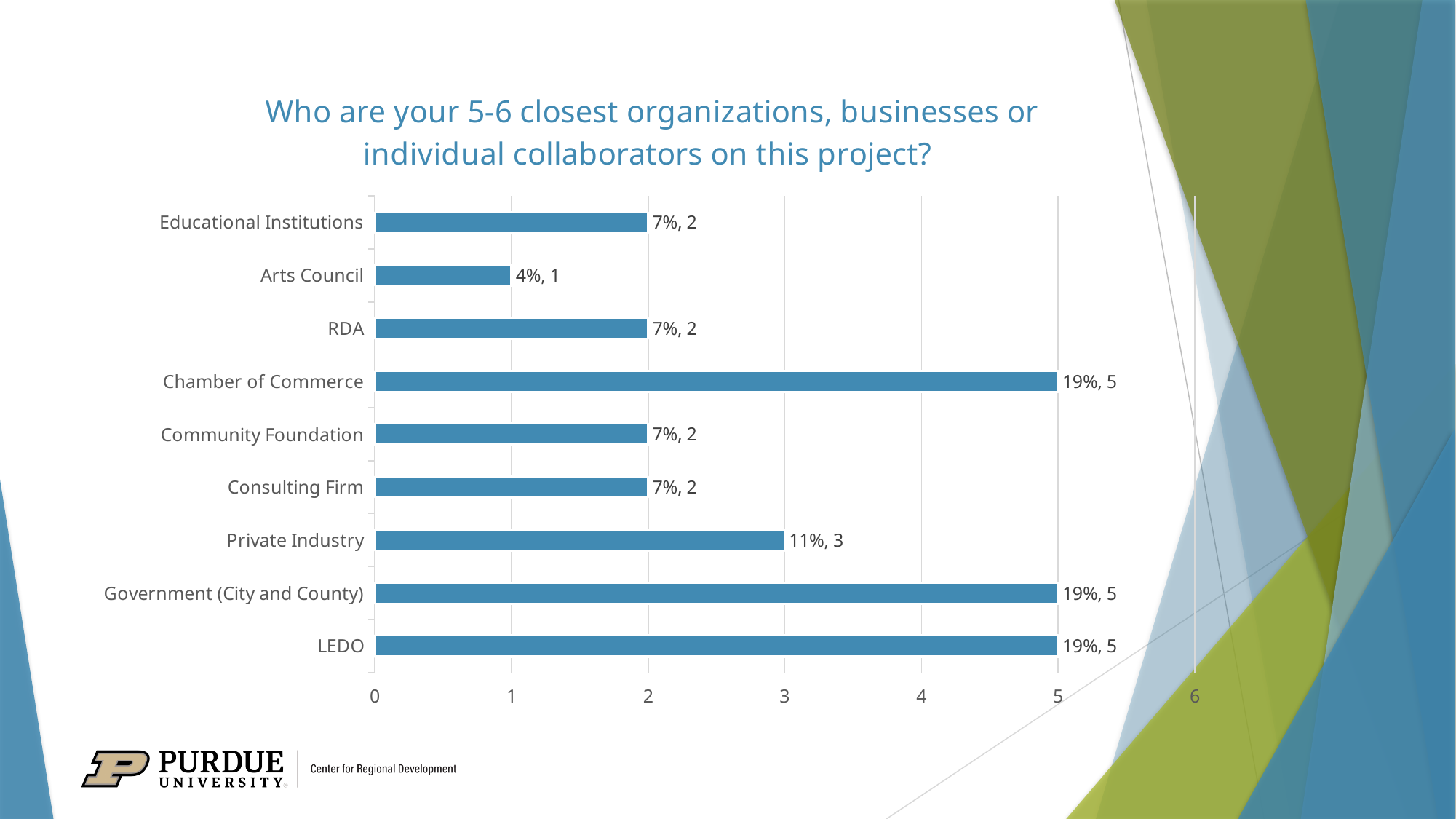
What kind of chart is shown on the slide? Bar chart How many categories are shown on the chart? 9 What is the title of the chart? Who are your 5-6 closest organizations, businesses or individual collaborators on this project? Which is larger, the count for Private Industry or the count for RDA? Private Industry What is the highest value shown on the x axis? 6 What count is shown for Chamber of Commerce? 5 Which category has the lowest value? Arts Council How many categories share the highest value of 5? 3 What is the data label shown for Private Industry? 11%, 3 What percentage is shown for Educational Institutions? 7% What is the difference in count between LEDO and Private Industry? 2 What is the data label shown for Arts Council? 4%, 1